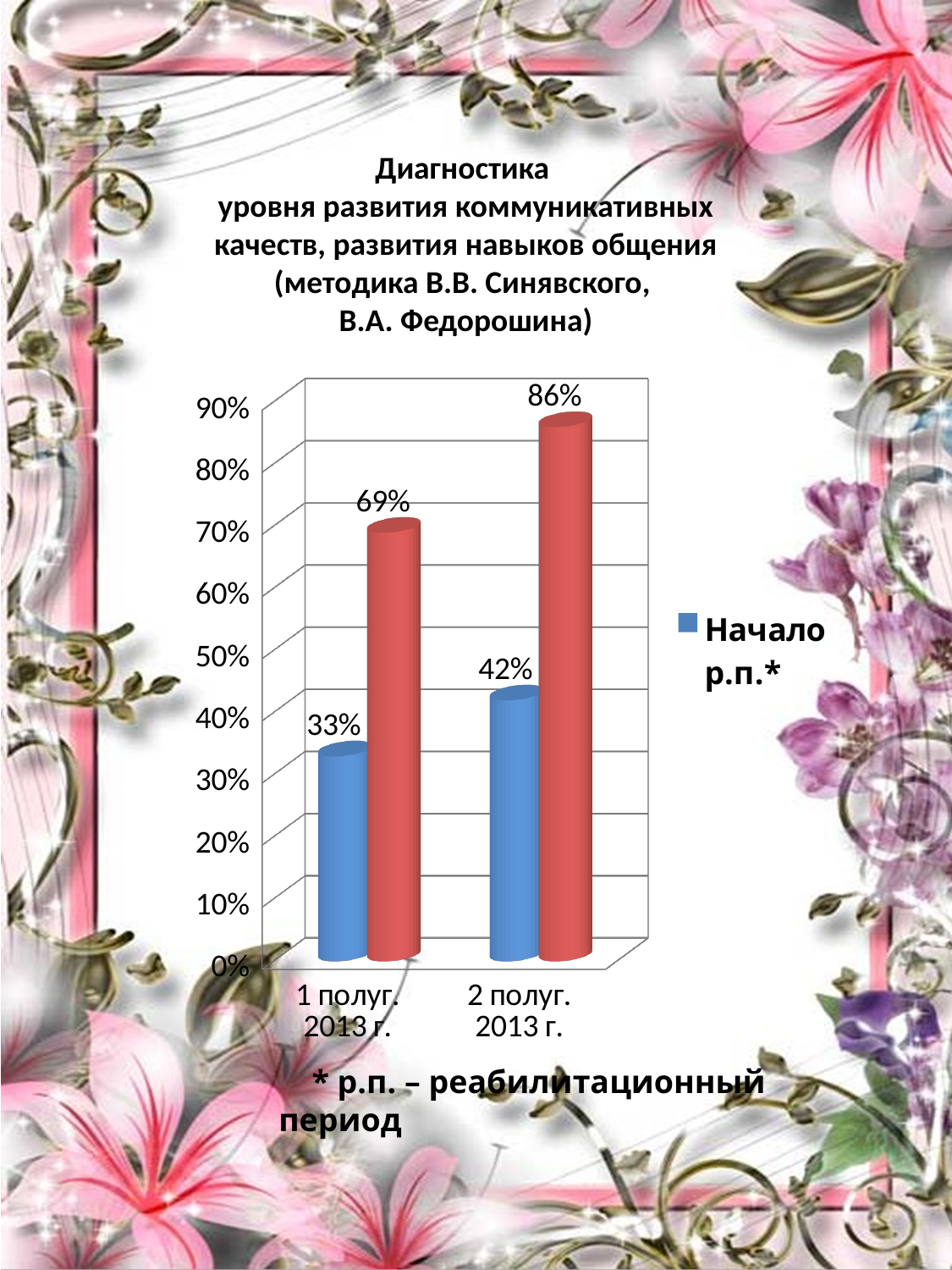
By how much did the 'Начало р.п.*' value increase from '1 полуг. 2013 г.' to '2 полуг. 2013 г.'? 9% What is the difference between the red bar and the blue bar for '2 полуг. 2013 г.'? 44% What is the value of the red bar for '2 полуг. 2013 г.'? 86% What type of chart is shown on the slide? Bar chart What is the value of the red bar for '1 полуг. 2013 г.'? 69% Which is larger: the red bar for '1 полуг. 2013 г.' or the blue bar for '2 полуг. 2013 г.'? The red bar for 1 полуг. 2013 г. (69%) What is the value of the blue 'Начало р.п.*' bar for '2 полуг. 2013 г.'? 42% Do the values of the red series rise or fall from '1 полуг. 2013 г.' to '2 полуг. 2013 г.'? Rise Which bar on the chart has the lowest value? The blue 'Начало р.п.*' bar for 1 полуг. 2013 г. (33%) Which bar on the chart has the highest value? The red bar for 2 полуг. 2013 г. (86%) What is the value of the blue 'Начало р.п.*' bar for '1 полуг. 2013 г.'? 33% How many categories are shown on the x axis of the chart? 2